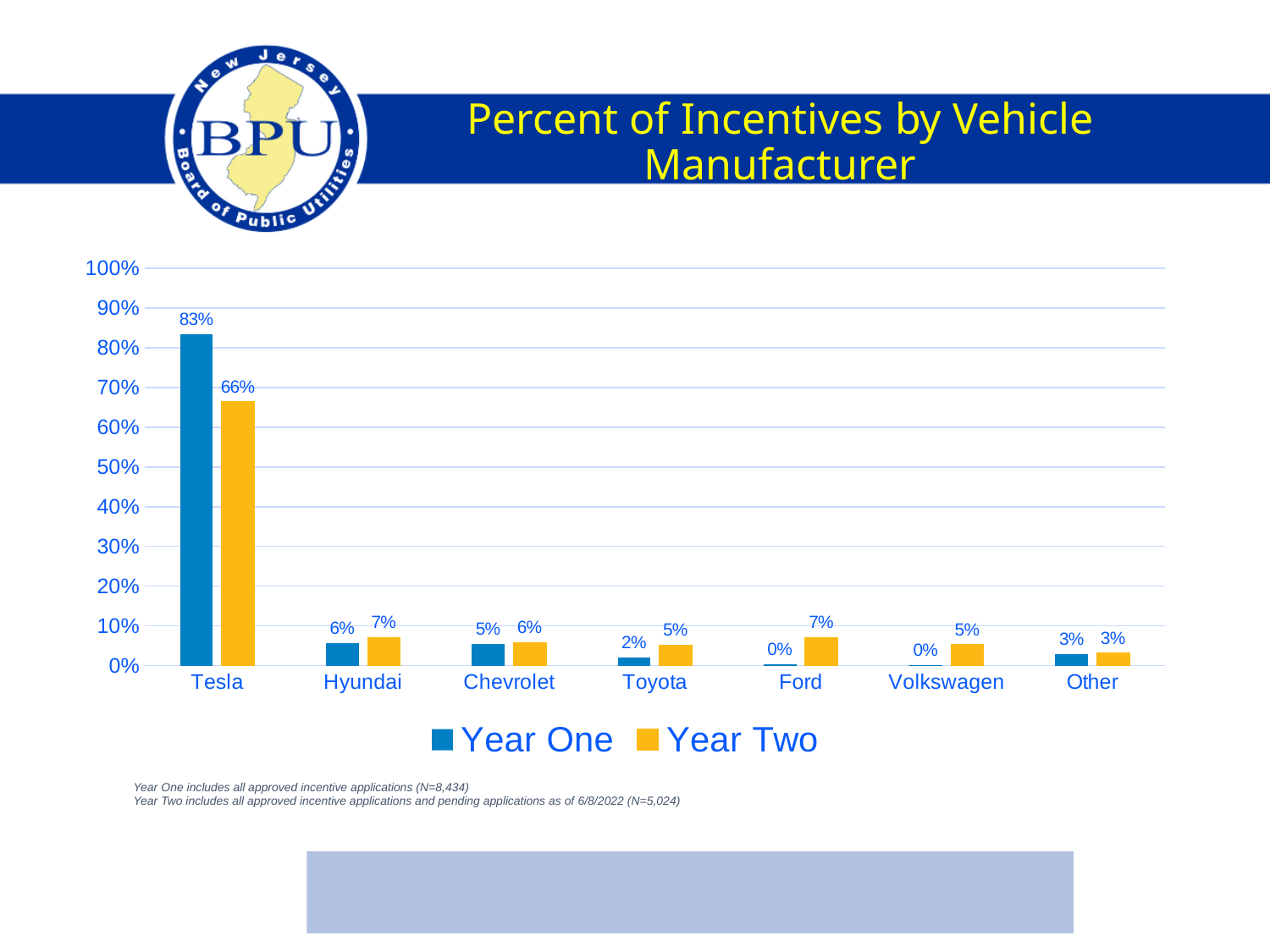
What is the difference between Tesla's Year One and Year Two values? 17% What kind of chart is shown on the slide? Bar chart What is the Year One value for Tesla? 83% How many series does the legend list? 2 What is the Year Two value for Ford? 7% Which is larger for Toyota, the Year One value or the Year Two value? Year Two What is the Year One value for Volkswagen? 0% Which manufacturer has the highest Year Two value? Tesla What is the title of the chart? Percent of Incentives by Vehicle Manufacturer Is the Year Two value for Tesla greater or less than 50%? greater How many manufacturer categories are shown on the x axis? 7 What colour represents the Year Two series? Yellow